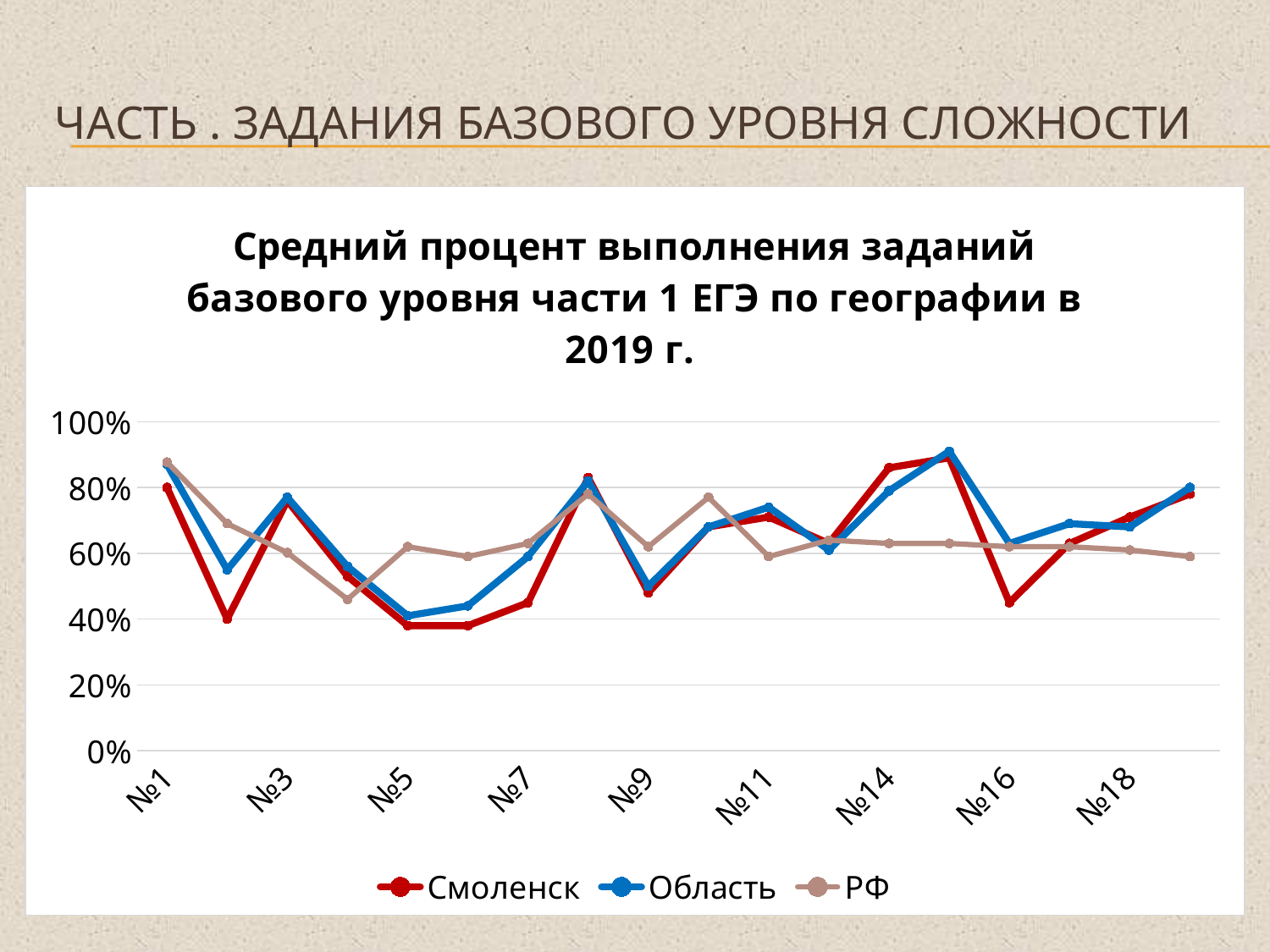
At №16, which series has the larger value, Смоленск or РФ? РФ What is the title of the chart? Средний процент выполнения заданий базового уровня части 1 ЕГЭ по географии в 2019 г. What are the three series named in the legend? Смоленск, Область, РФ Is the value for Область at №1 greater or less than 80%? greater How many series does the legend list? 3 Is the value for Смоленск at №5 greater or less than 60%? less Is the value for Смоленск at №3 greater or less than 60%? greater What kind of chart is shown on the slide? line chart Does the Смоленск line rise or fall from №16 to №18? rise